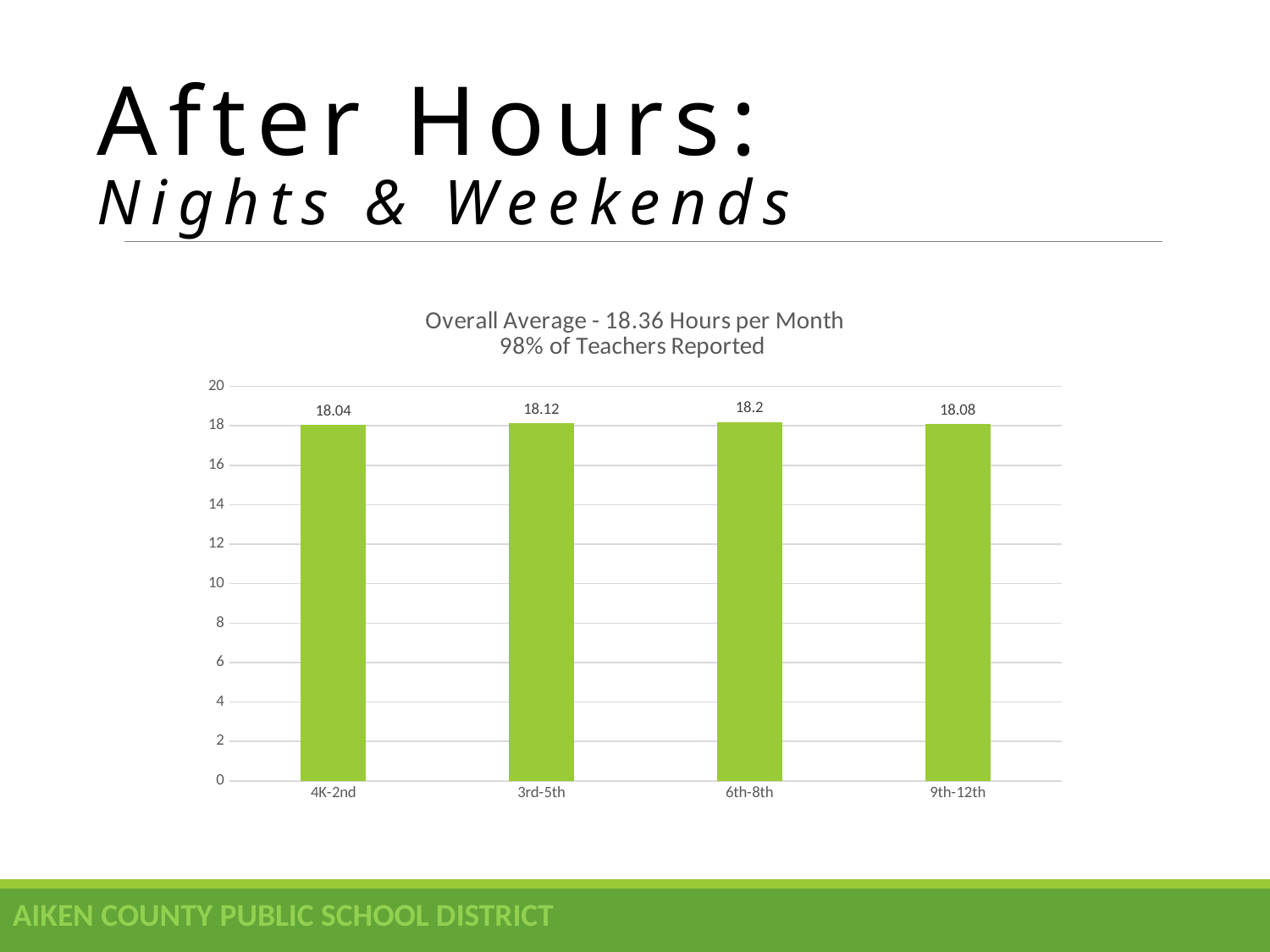
What is the value for 4K-2nd? 18.04 What is the value for 6th-8th? 18.2 What is the difference between the values for 6th-8th and 4K-2nd? 0.16 Which grade band has the highest value? 6th-8th How many grade bands are shown on the chart? 4 Which grade band has the lowest value? 4K-2nd What is the value for 9th-12th? 18.08 What overall average is stated in the chart title? 18.36 Hours per Month Which is larger, the value for 3rd-5th or the value for 9th-12th? 3rd-5th According to the chart title, what percentage of teachers reported? 98% What kind of chart is shown on the slide? bar chart Is the value for 3rd-5th greater or less than 16? greater